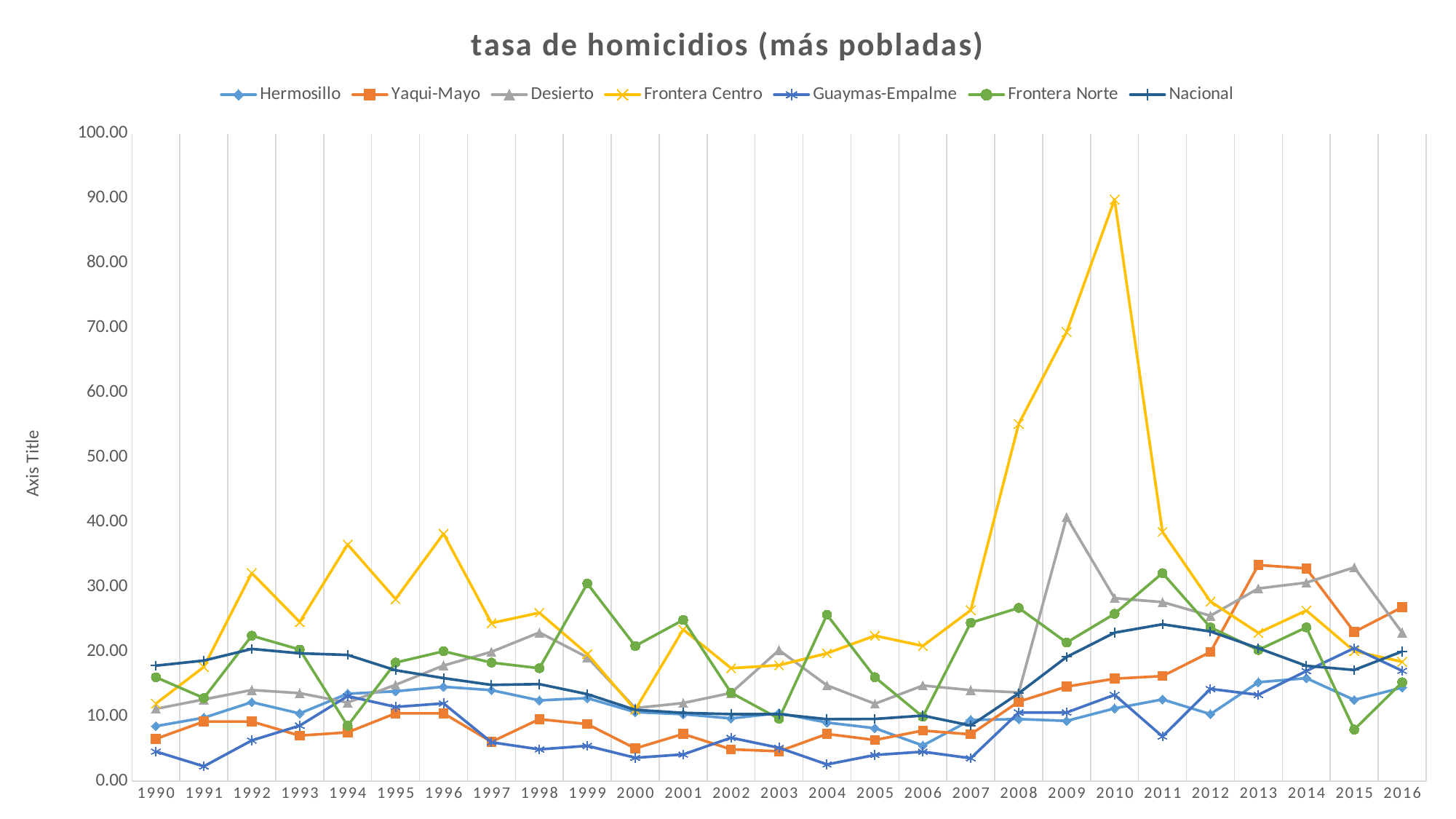
What is the title of the chart? tasa de homicidios (más pobladas) In which year does the Frontera Centro series reach its peak? 2010 How many years are plotted along the x axis? 27 Is the value for Frontera Centro in 2010 greater or less than 80? greater Which series reaches the highest value anywhere on the chart? Frontera Centro How many series does the legend list? 7 What kind of chart is shown on the slide? line chart Is the value for Desierto in 2009 greater or less than 30? greater In 2009, which series has the higher value, Frontera Centro or Desierto? Frontera Centro Which series has the lowest value in 1991? Guaymas-Empalme Does the Frontera Centro series rise or fall from 2010 to 2013? fall Is the value for Frontera Norte in 2015 greater or less than 10? less